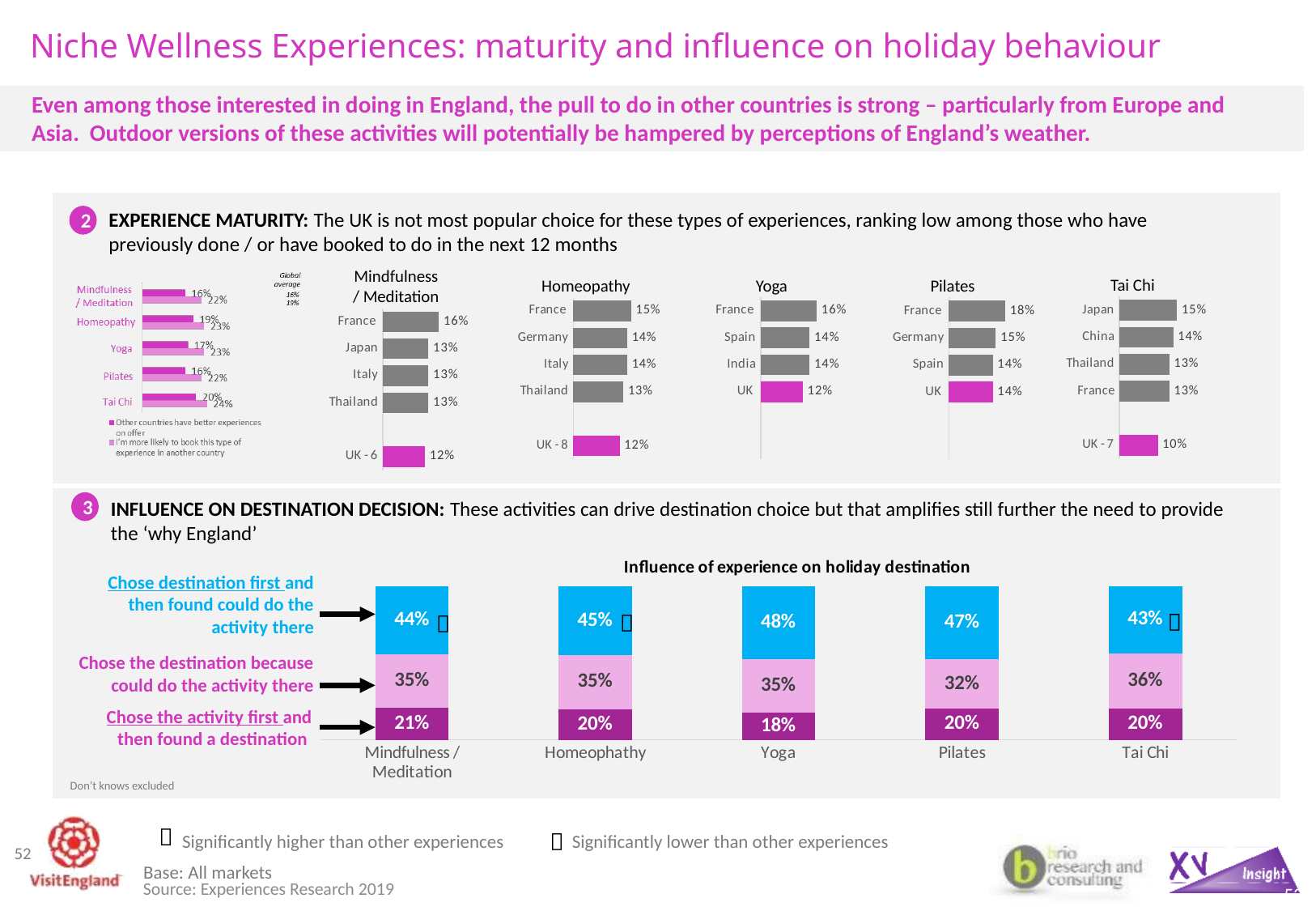
In the Pilates chart in the Experience Maturity section, what is the value for Germany? 15% In the Yoga chart in the Experience Maturity section, what is the difference between France and the UK? 4% In the 'Influence of experience on holiday destination' chart, is the 'Chose the destination because could do the activity there' value larger for Tai Chi or for Pilates? Tai Chi In the 'Influence of experience on holiday destination' chart, what is the total of the stacked bar for Homeopathy? 100% In the Homeopathy chart in the Experience Maturity section, which country has the highest value? France In the 'Influence of experience on holiday destination' chart, what share of Yoga respondents chose the destination first and then found they could do the activity there? 48% In the Tai Chi chart in the Experience Maturity section, which country has the lowest value? UK What type of chart is the 'Influence of experience on holiday destination' chart? Stacked bar chart In the Tai Chi chart in the Experience Maturity section, how many countries are shown? 5 In the 'Influence of experience on holiday destination' chart, which activity has the highest share for 'Chose the activity first and then found a destination'? Mindfulness / Meditation In the Mindfulness / Meditation chart in the Experience Maturity section, what is the value for the UK? 12% In the Mindfulness / Meditation chart in the Experience Maturity section, what is the value for France? 16%